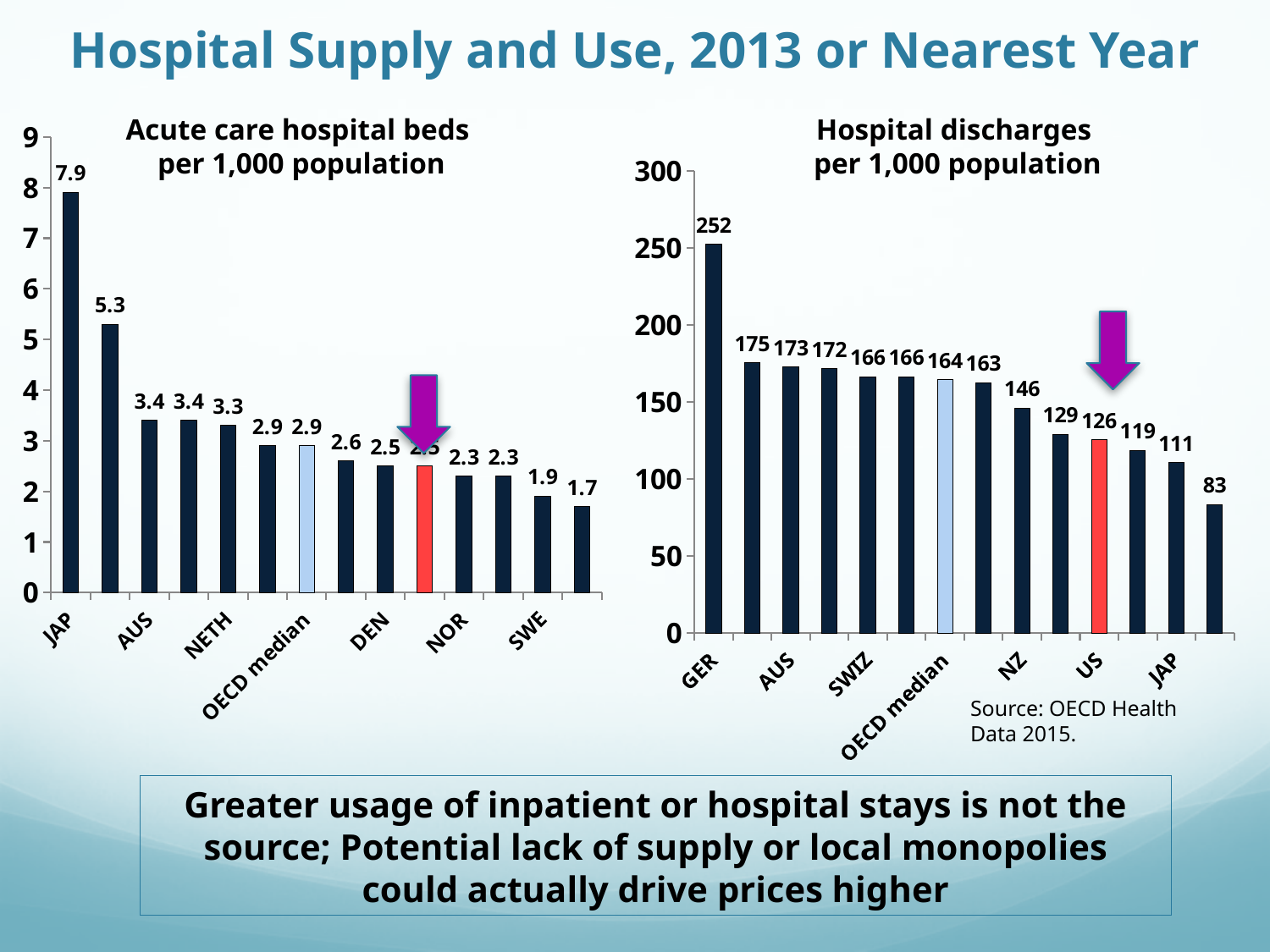
In the 'Hospital discharges per 1,000 population' chart, which country has the highest value? GER What type of chart is the 'Hospital discharges per 1,000 population' chart? Bar chart In the 'Hospital discharges per 1,000 population' chart, which is larger, the value for NZ or the value for JAP? NZ In the 'Hospital discharges per 1,000 population' chart, what is the value for GER? 252 In the 'Acute care hospital beds per 1,000 population' chart, what is the difference between the values for JAP and AUS? 4.5 In the 'Acute care hospital beds per 1,000 population' chart, what is the value for SWE? 1.9 How many bars are plotted in the 'Acute care hospital beds per 1,000 population' chart? 14 In the 'Hospital discharges per 1,000 population' chart, what is the difference between the values for GER and US? 126 In the 'Acute care hospital beds per 1,000 population' chart, what is the value for JAP? 7.9 In the 'Acute care hospital beds per 1,000 population' chart, which labelled country has the highest value? JAP In the 'Acute care hospital beds per 1,000 population' chart, what is the value for the OECD median? 2.9 In the 'Hospital discharges per 1,000 population' chart, what is the value for US? 126